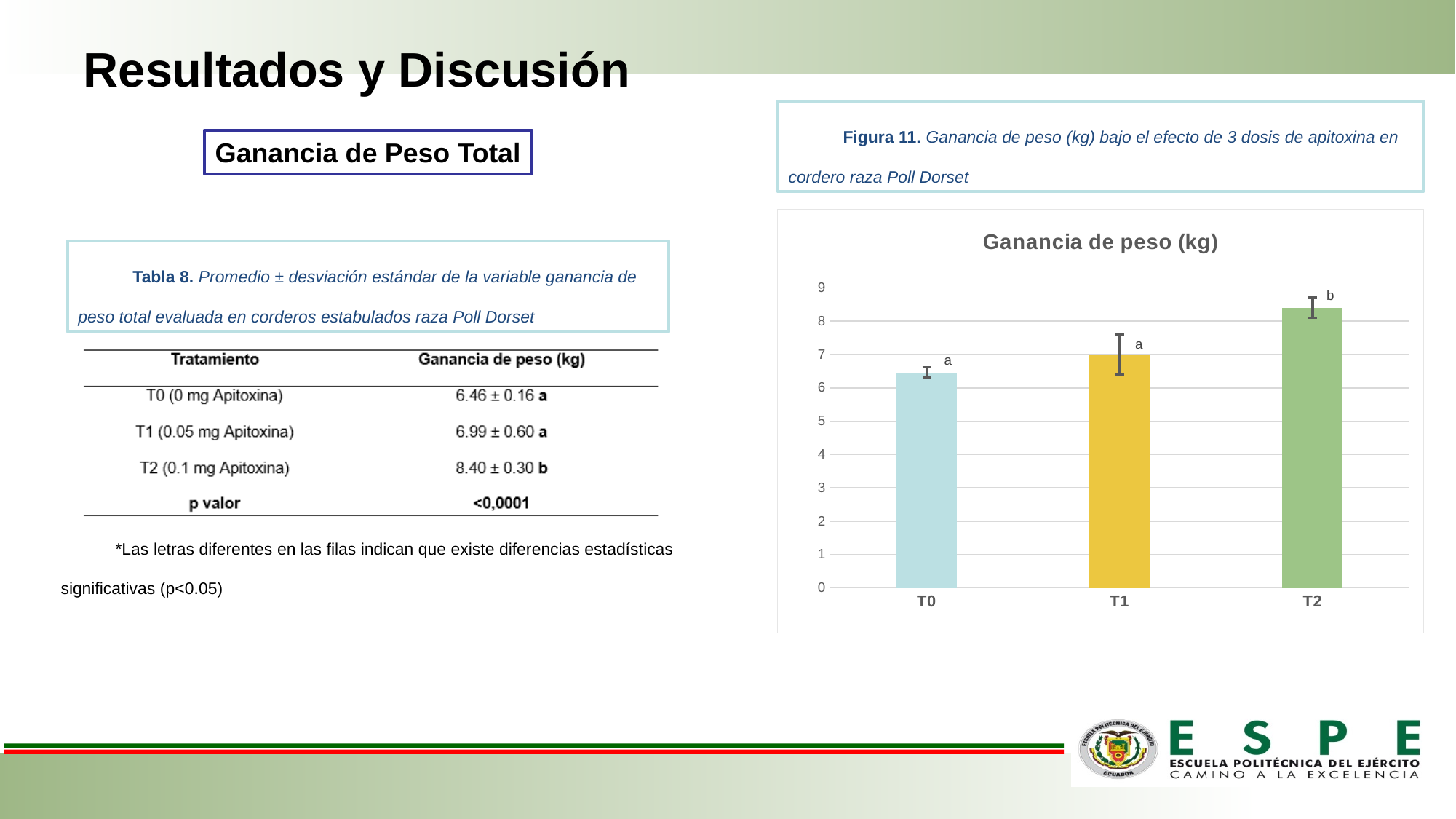
Which letter is placed above the T2 bar in the chart? b Is the value for T1 greater or less than 6? greater How many treatment categories are plotted on the x axis of the chart? 3 What type of chart is shown on the slide? bar chart Do the bar values rise or fall from T0 to T2 along the x axis? rise Which treatment has the highest weight gain in the chart? T2 What is the maximum value shown on the chart's y axis? 9 What is the title of the chart? Ganancia de peso (kg) Which is larger in the chart, the value for T2 or the value for T0? T2 Which treatment has the lowest weight gain in the chart? T0 Is the value for T2 greater or less than 8? greater Is the value for T0 greater or less than 7? less